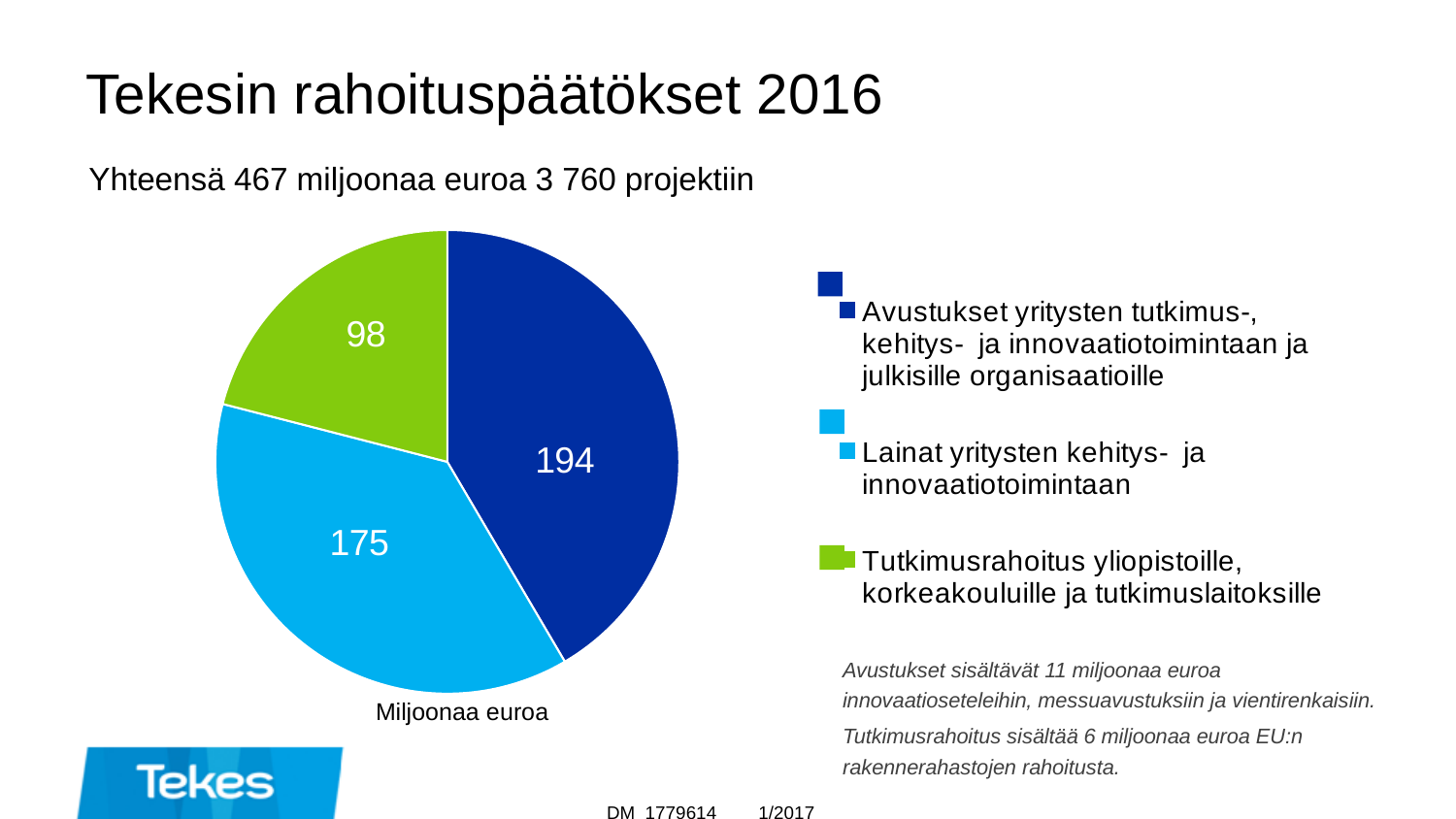
What is the value for 'Avustukset yritysten tutkimus-, kehitys- ja innovaatiotoimintaan ja julkisille organisaatioille' in the pie chart? 194 What is the value for 'Lainat yritysten kehitys- ja innovaatiotoimintaan' in the pie chart? 175 How many slices does the pie chart have? 3 What is the value for 'Tutkimusrahoitus yliopistoille, korkeakouluille ja tutkimuslaitoksille' in the pie chart? 98 What kind of chart is shown on the slide? pie chart Which is larger in the pie chart: the 'Lainat yritysten kehitys- ja innovaatiotoimintaan' slice or the 'Tutkimusrahoitus' slice? Lainat yritysten kehitys- ja innovaatiotoimintaan How many entries does the legend of the pie chart list? 3 What unit label is shown below the pie chart? Miljoonaa euroa Which category has the largest slice in the pie chart? Avustukset yritysten tutkimus-, kehitys- ja innovaatiotoimintaan ja julkisille organisaatioille What is the difference between the 'Avustukset' slice and the 'Lainat' slice in the pie chart? 19 What share of the pie chart total does the 'Tutkimusrahoitus yliopistoille, korkeakouluille ja tutkimuslaitoksille' slice represent? 21% Which category has the smallest slice in the pie chart? Tutkimusrahoitus yliopistoille, korkeakouluille ja tutkimuslaitoksille